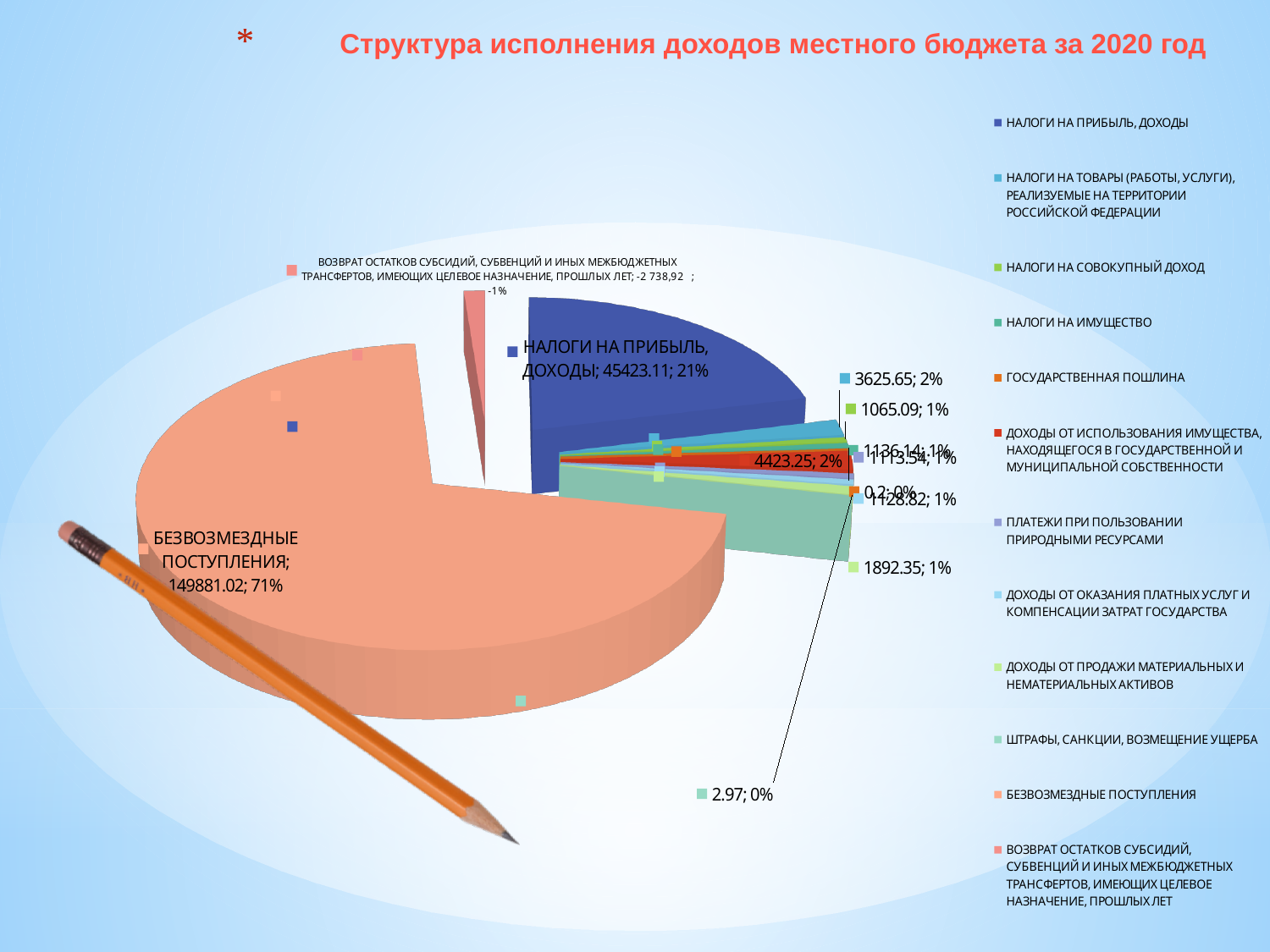
What is the difference between the values for БЕЗВОЗМЕЗДНЫЕ ПОСТУПЛЕНИЯ and НАЛОГИ НА ПРИБЫЛЬ, ДОХОДЫ? 104457.91 What share of the pie does БЕЗВОЗМЕЗДНЫЕ ПОСТУПЛЕНИЯ represent? 71% Which category has the largest slice of the pie? БЕЗВОЗМЕЗДНЫЕ ПОСТУПЛЕНИЯ What value is shown for ВОЗВРАТ ОСТАТКОВ СУБСИДИЙ, СУБВЕНЦИЙ И ИНЫХ МЕЖБЮДЖЕТНЫХ ТРАНСФЕРТОВ, ИМЕЮЩИХ ЦЕЛЕВОЕ НАЗНАЧЕНИЕ, ПРОШЛЫХ ЛЕТ? -2 738,92 How many entries does the chart legend list? 12 What is the first entry listed in the chart legend? НАЛОГИ НА ПРИБЫЛЬ, ДОХОДЫ What value is shown for БЕЗВОЗМЕЗДНЫЕ ПОСТУПЛЕНИЯ? 149881.02 What share of the pie does НАЛОГИ НА ПРИБЫЛЬ, ДОХОДЫ represent? 21% What value is shown for НАЛОГИ НА ПРИБЫЛЬ, ДОХОДЫ? 45423.11 What is the title of the chart? Структура исполнения доходов местного бюджета за 2020 год What kind of chart is shown on the slide? pie chart Which is larger, the value for БЕЗВОЗМЕЗДНЫЕ ПОСТУПЛЕНИЯ or the value for НАЛОГИ НА ПРИБЫЛЬ, ДОХОДЫ? БЕЗВОЗМЕЗДНЫЕ ПОСТУПЛЕНИЯ